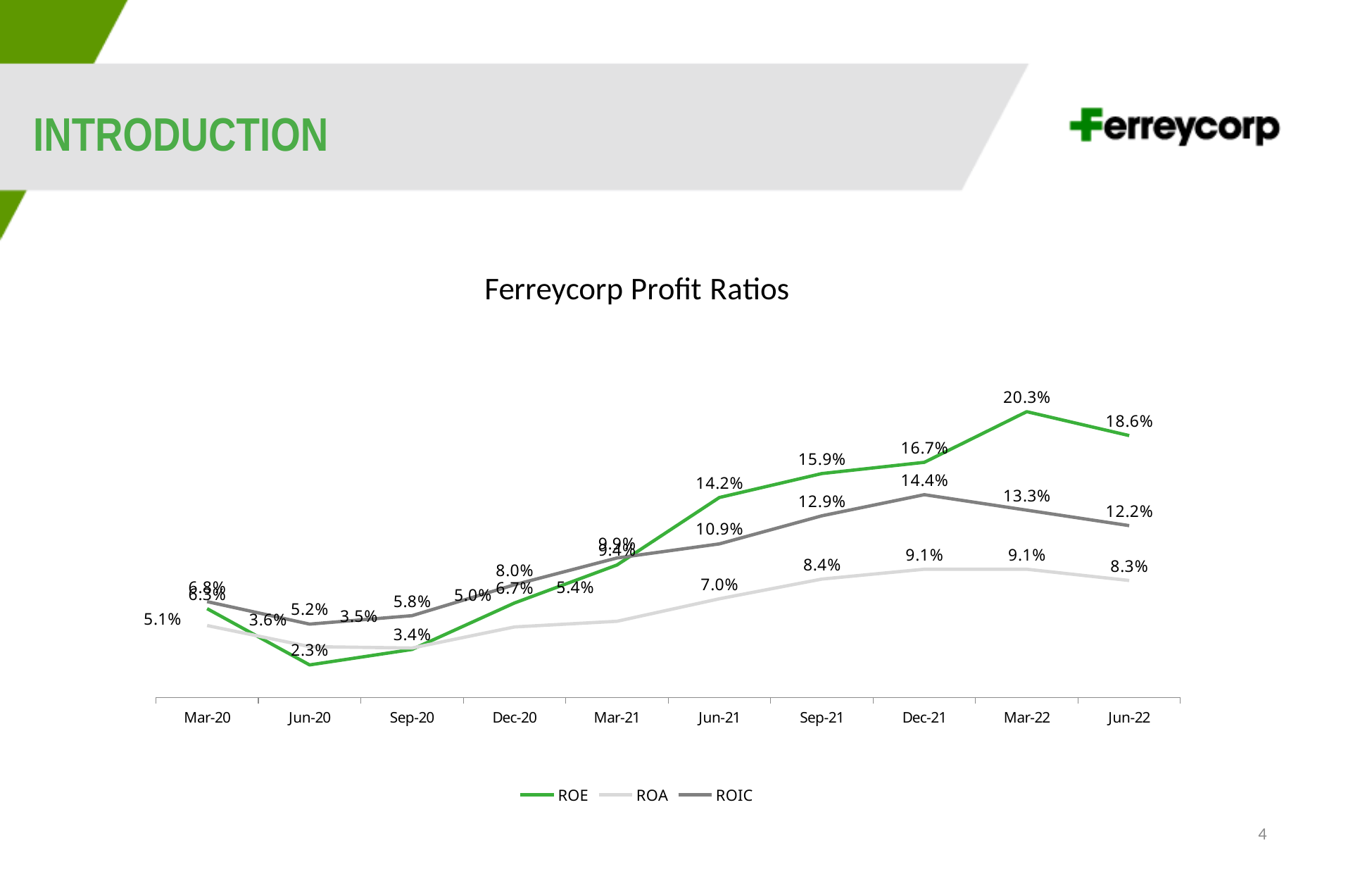
What is the ROA value for Jun-21? 7.0% What is the ROE value for Jun-20? 2.3% In which period is ROE at its lowest value? Jun-20 What kind of chart is shown on the slide? Line chart What is the ROE value for Mar-22? 20.3% How many series does the legend list? 3 Which is larger in Sep-21, ROE or ROIC? ROE In which period does ROE reach its highest value? Mar-22 What is the ROIC value for Dec-21? 14.4% How many periods are shown on the x axis? 10 Does ROE rise or fall from Jun-20 to Mar-22? Rise What is the difference between ROE and ROIC in Jun-22? 6.4%